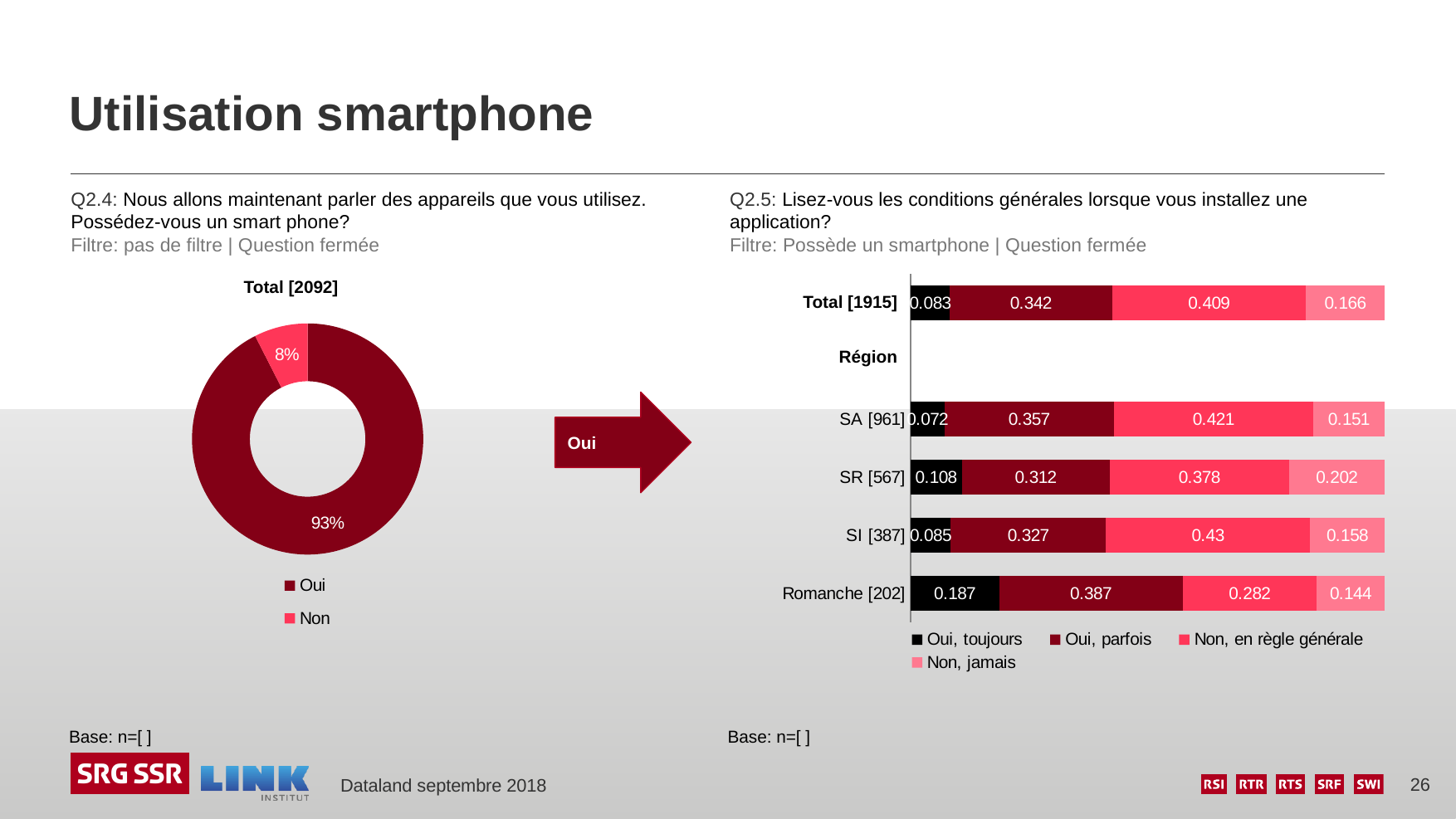
In the right chart (Q2.5), what is the value of 'Oui, toujours' for Romanche [202]? 0.187 In the right chart (Q2.5), what is the value of 'Oui, parfois' for Total [1915]? 0.342 In the right chart (Q2.5), is the 'Oui, parfois' value larger for SA [961] or for SI [387]? SA [961] In the left chart (Total [2092]), what percentage answered Oui? 93% In the right chart (Q2.5), which region has the highest value for 'Oui, toujours'? Romanche [202] In the left chart (Total [2092]), what percentage answered Non? 8% How many series does the legend of the right chart (Q2.5) list? 4 In the right chart (Q2.5), what is the value of 'Non, jamais' for SR [567]? 0.202 How many series does the legend of the left chart (Total [2092]) list? 2 What kind of chart is the left chart (Total [2092])? Donut chart In the right chart (Q2.5), which region has the lowest value for 'Non, en règle générale'? Romanche [202] In the right chart (Q2.5), what is the difference between the 'Non, en règle générale' values for SA [961] and SR [567]? 0.043